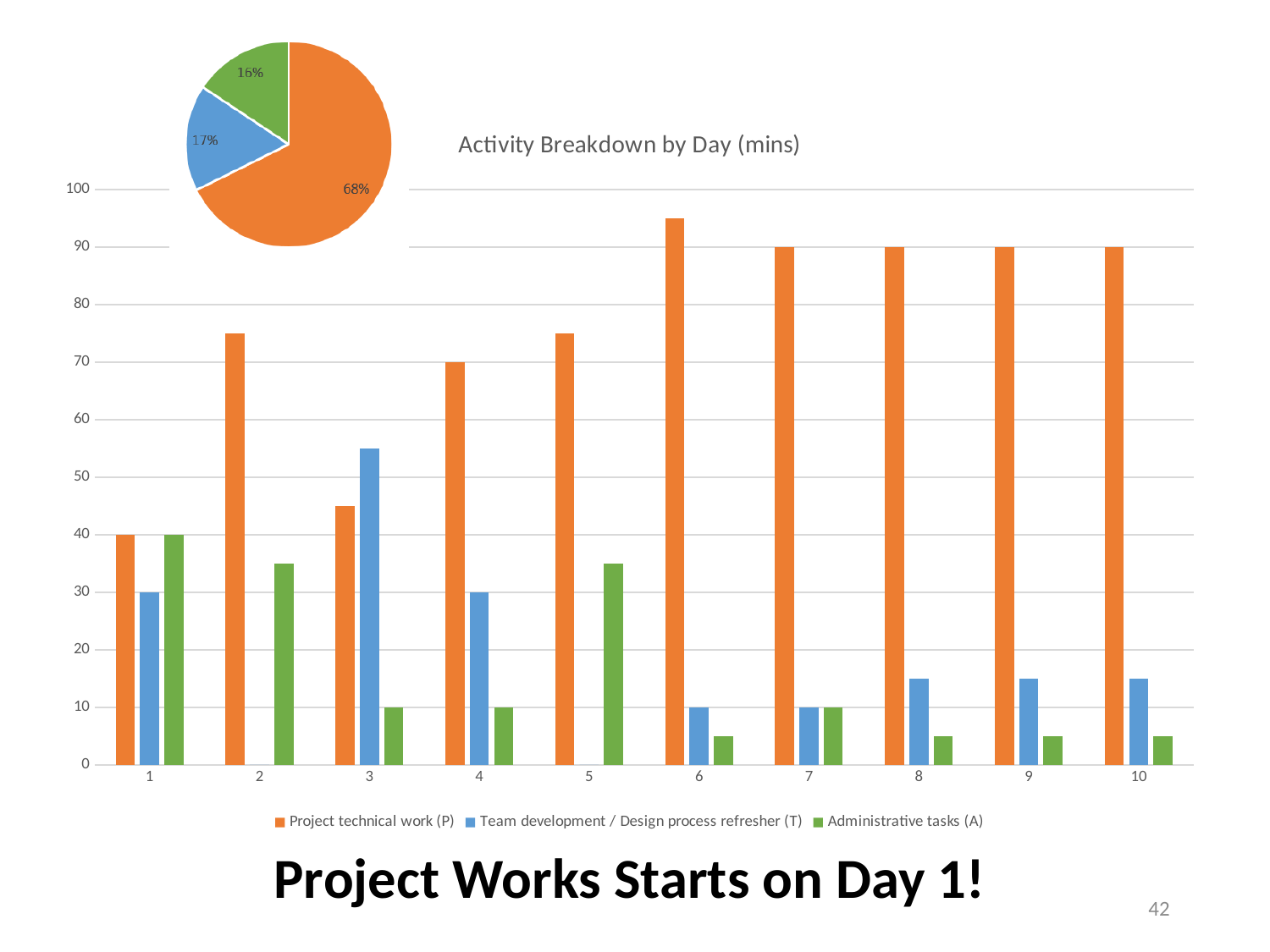
How many series does the legend of the 'Activity Breakdown by Day (mins)' chart list? 3 In the 'Activity Breakdown by Day (mins)' chart, which day has the lowest value for Project technical work (P)? 1 In the 'Activity Breakdown by Day (mins)' chart, what is the value for Team development / Design process refresher (T) on day 4? 30 What kind of chart is the 'Activity Breakdown by Day (mins)' chart? bar chart In the 'Activity Breakdown by Day (mins)' chart, what is the difference between Project technical work (P) and Team development / Design process refresher (T) on day 1? 10 In the 'Activity Breakdown by Day (mins)' chart, what is the value for Project technical work (P) on day 1? 40 How many days are shown on the x axis of the 'Activity Breakdown by Day (mins)' chart? 10 In the 'Activity Breakdown by Day (mins)' chart, is the value for Team development / Design process refresher (T) on day 3 greater or less than 50? greater In the 'Activity Breakdown by Day (mins)' chart, which day has the highest value for Project technical work (P)? 6 In the 'Activity Breakdown by Day (mins)' chart, is the value for Project technical work (P) on day 2 greater or less than 70? greater In the pie chart at the top left of the slide, what share does the largest slice represent? 68% In the 'Activity Breakdown by Day (mins)' chart, on day 3, which is larger: Project technical work (P) or Team development / Design process refresher (T)? Team development / Design process refresher (T)